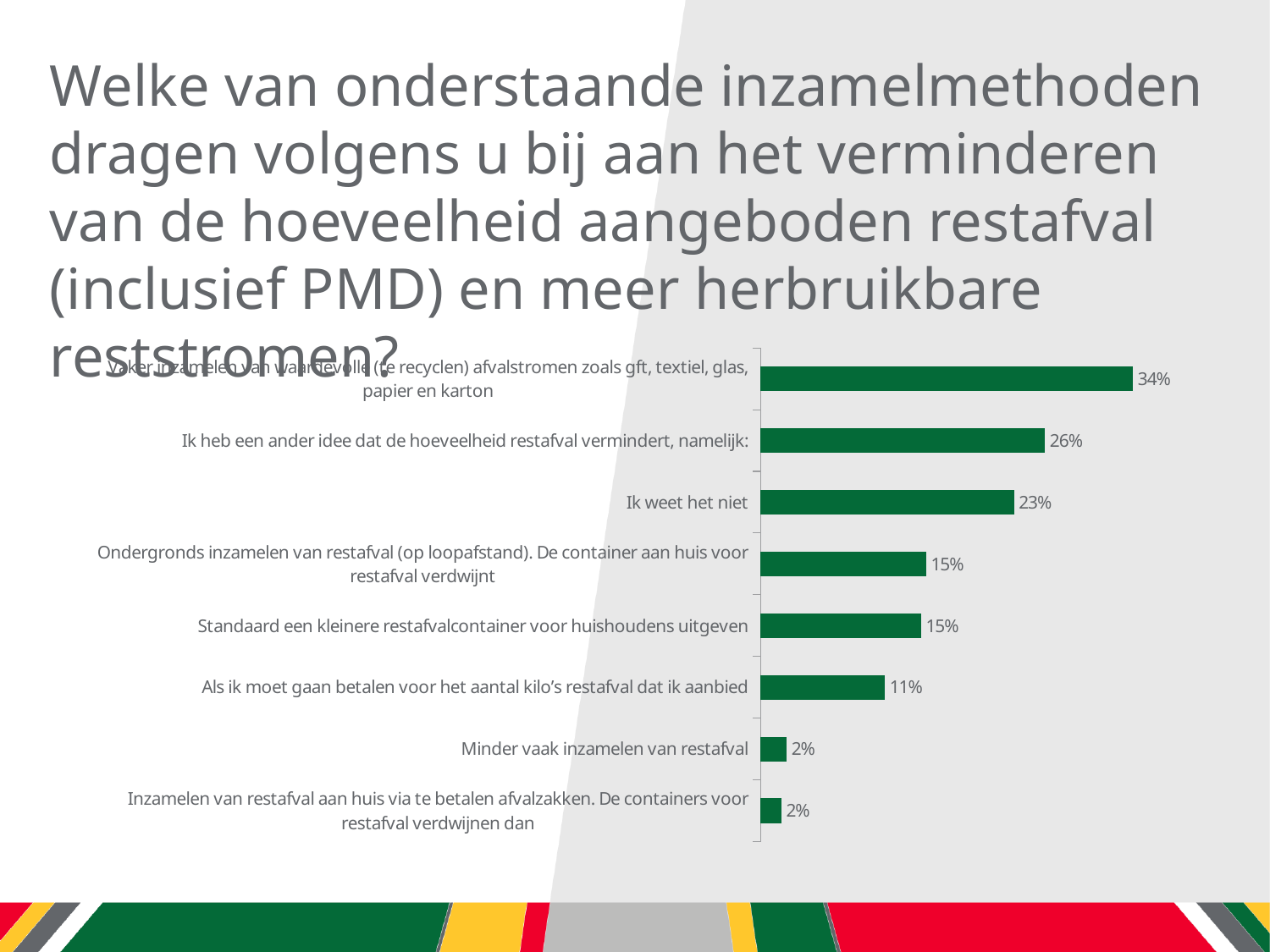
What is the value for "Als ik moet gaan betalen voor het aantal kilo's restafval dat ik aanbied"? 11% Which is larger: "Ik weet het niet" or "Ondergronds inzamelen van restafval (op loopafstand). De container aan huis voor restafval verdwijnt"? Ik weet het niet What is the value for "Ik heb een ander idee dat de hoeveelheid restafval vermindert, namelijk:"? 26% What colour are the bars in the chart? green What is the highest value shown in the chart? 34% What is the value for "Minder vaak inzamelen van restafval"? 2% How many categories (bars) does the chart show? 8 What is the difference between "Ik heb een ander idee dat de hoeveelheid restafval vermindert, namelijk:" and "Ik weet het niet"? 3% What is the value for "Ik weet het niet"? 23% What kind of chart is shown on the slide? bar chart What is the value for "Standaard een kleinere restafvalcontainer voor huishoudens uitgeven"? 15% What is the value of the top bar in the chart? 34%